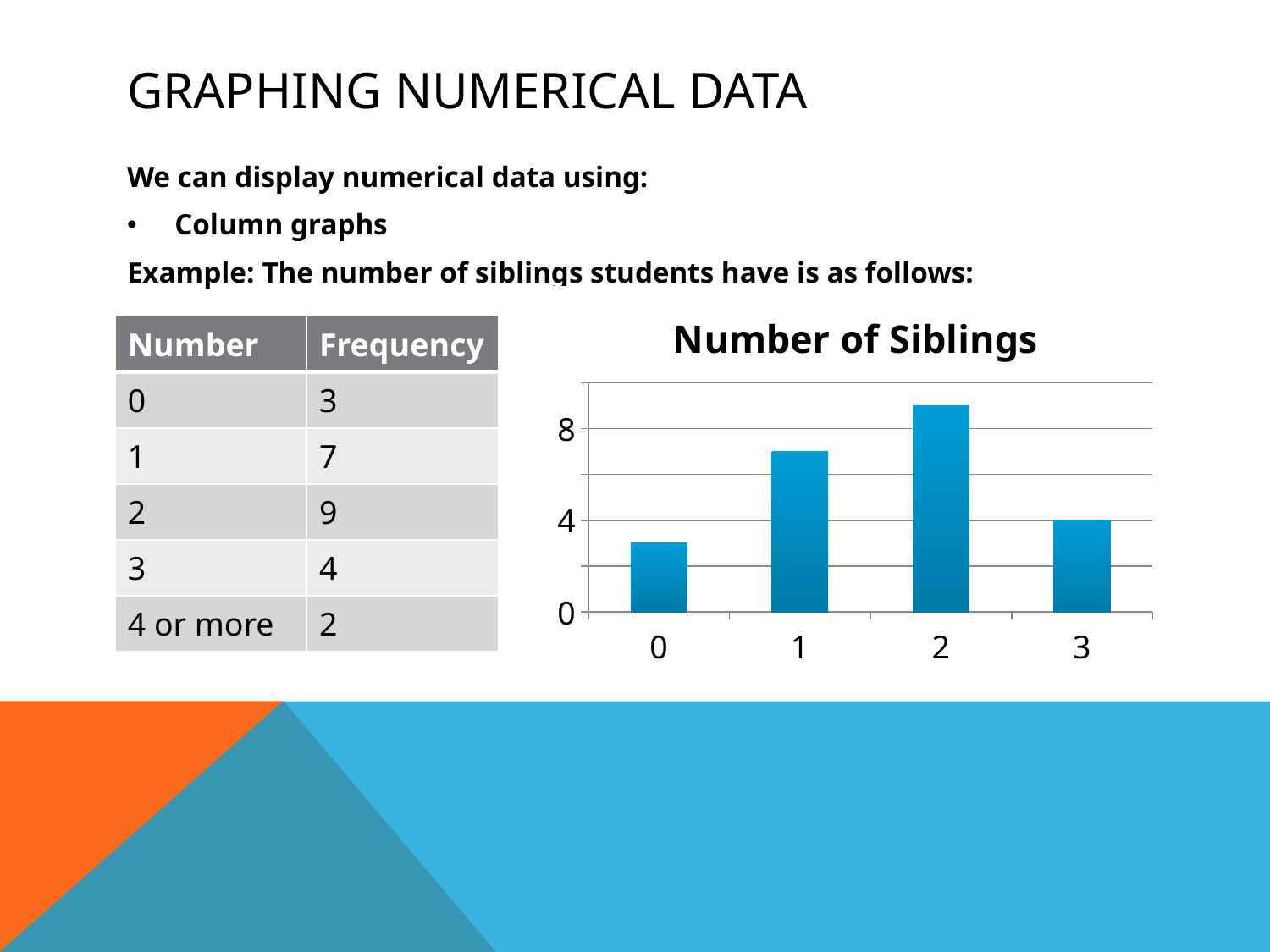
What is the title of the chart? Number of Siblings Which category has the shortest bar in the chart? 0 Which bar is taller, category 1 or category 3? 1 What is the value of the bar for category 3? 4 Is the value for category 2 greater or less than 8? greater Is the value for category 1 greater or less than 4? greater What kind of chart is shown on the slide? bar chart How many bars does the chart show? 4 Is the value for category 0 greater or less than 4? less Which category has the tallest bar in the chart? 2 Do the bar values rise or fall from category 2 to category 3? fall